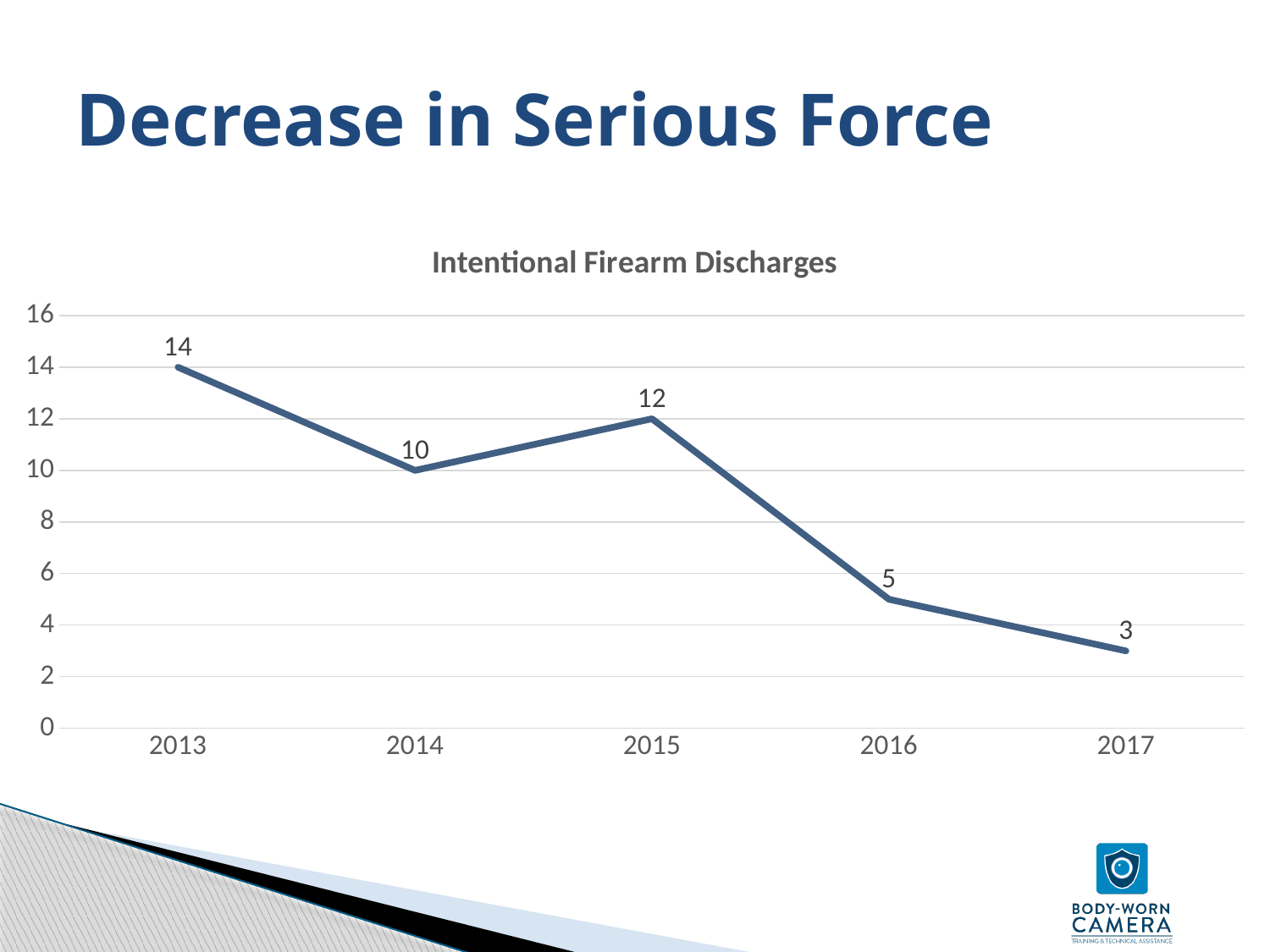
Which is larger, the value for 2014 or the value for 2015? 2015 How many years are plotted on the chart? 5 What is the value for 2013? 14 What kind of chart is shown? line chart What is the value for 2017? 3 Do the values generally rise or fall from 2013 to 2017? fall Which year has the highest value? 2013 What is the value for 2016? 5 What is the difference between the values for 2015 and 2016? 7 Which year has the lowest value? 2017 What is the title of the chart? Intentional Firearm Discharges What is the difference between the values for 2013 and 2017? 11